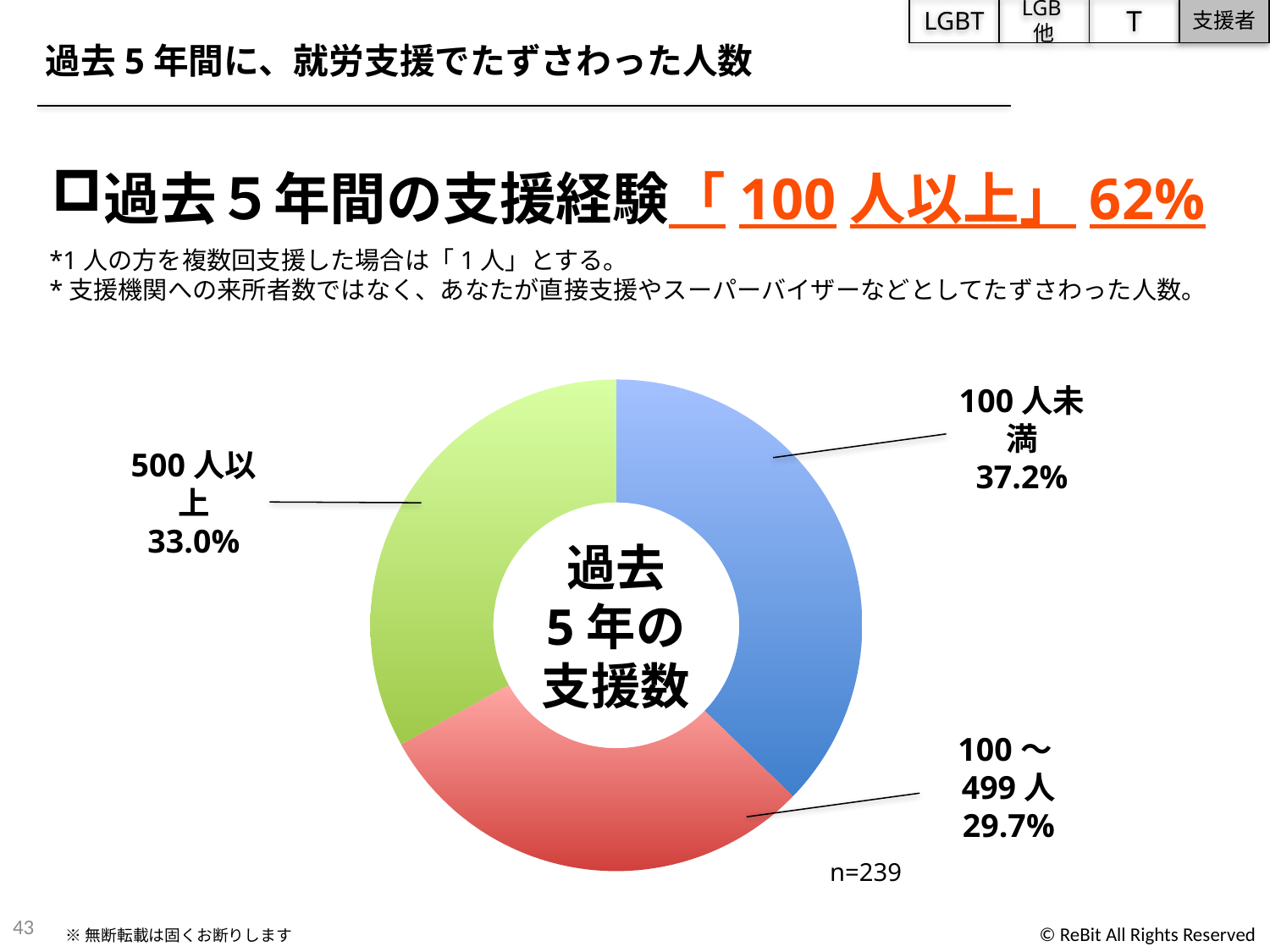
What is the share for 500人以上? 33.0% What kind of chart is shown on the slide? Donut (pie) chart What text is written in the centre of the donut chart? 過去5年の支援数 What is the share for 100人未満? 37.2% Which category has the smallest share? 100～499人 What is the share for 100～499人? 29.7% What is the difference between the shares for 500人以上 and 100～499人? 3.3% Which is larger, the share for 500人以上 or the share for 100～499人? 500人以上 What is the difference between the shares for 100人未満 and 100～499人? 7.5% How many categories does the chart show? 3 What is the sample size (n) shown next to the chart? n=239 Which category has the largest share? 100人未満